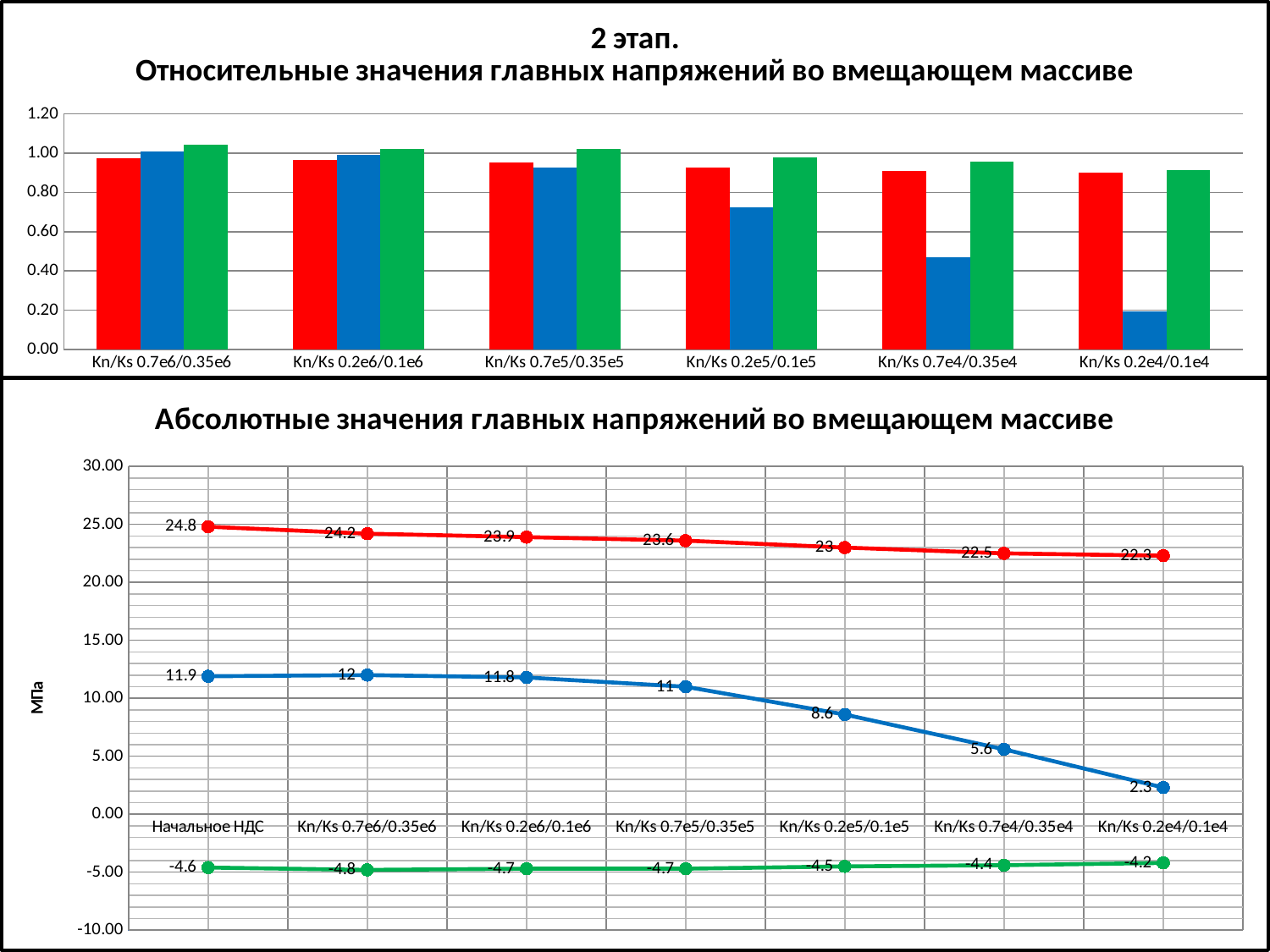
What kind of chart is the top chart titled "2 этап. Относительные значения главных напряжений во вмещающем массиве"? bar chart In the top bar chart, is the blue bar for Kn/Ks 0.2e4/0.1e4 greater or less than 0.40? less In the bottom line chart, what is the value of the green series at Kn/Ks 0.7e6/0.35e6? -4.8 What kind of chart is the bottom chart titled "Абсолютные значения главных напряжений во вмещающем массиве"? line chart In the bottom line chart, what is the difference between the blue series values at Начальное НДС and Kn/Ks 0.2e4/0.1e4? 9.6 In the top bar chart, how many categories are shown on the x axis? 6 In the top bar chart, is the blue bar for Kn/Ks 0.2e5/0.1e5 greater or less than 0.60? greater In the bottom line chart, what is the value of the red series at Начальное НДС? 24.8 In the bottom line chart, what is the label on the vertical axis? МПа In the bottom line chart, at which category is the blue series lowest? Kn/Ks 0.2e4/0.1e4 In the bottom line chart, what is the value of the blue series at Kn/Ks 0.2e4/0.1e4? 2.3 In the top bar chart, do the blue bars rise or fall from left to right along the x axis? fall